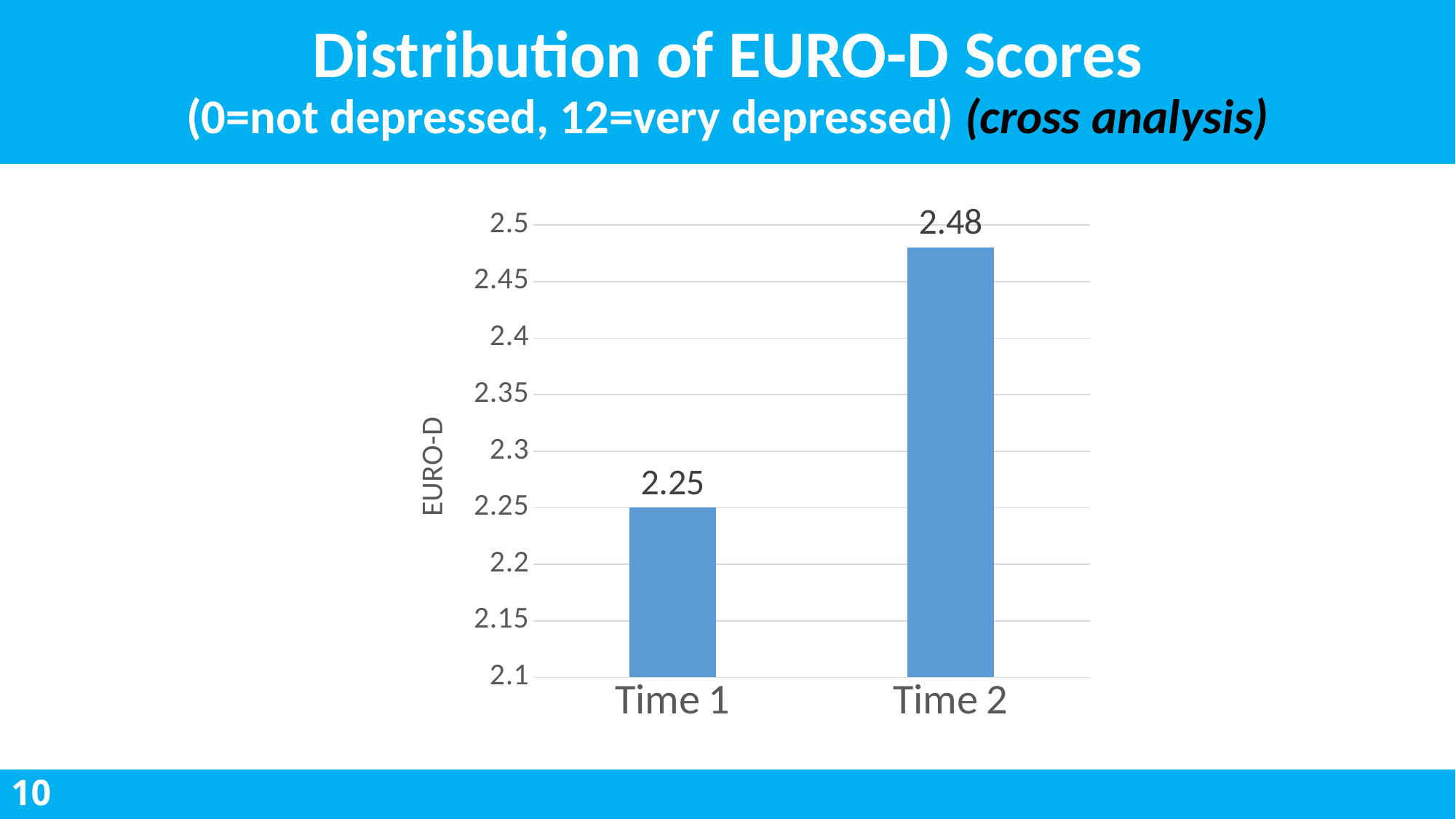
Is the value for Time 2 greater or less than 2.4? greater What is the EURO-D score for Time 1? 2.25 What kind of chart is shown on the slide? Bar chart What is the EURO-D score for Time 2? 2.48 Is the value for Time 1 greater or less than 2.3? less What is the label of the vertical axis? EURO-D What is the difference between the EURO-D scores at Time 2 and Time 1? 0.23 Which time point has the higher EURO-D score? Time 2 Do the EURO-D scores rise or fall from Time 1 to Time 2? Rise How many categories are shown on the x axis? 2 Is the EURO-D score at Time 2 larger than at Time 1? Yes Which time point has the lower EURO-D score? Time 1